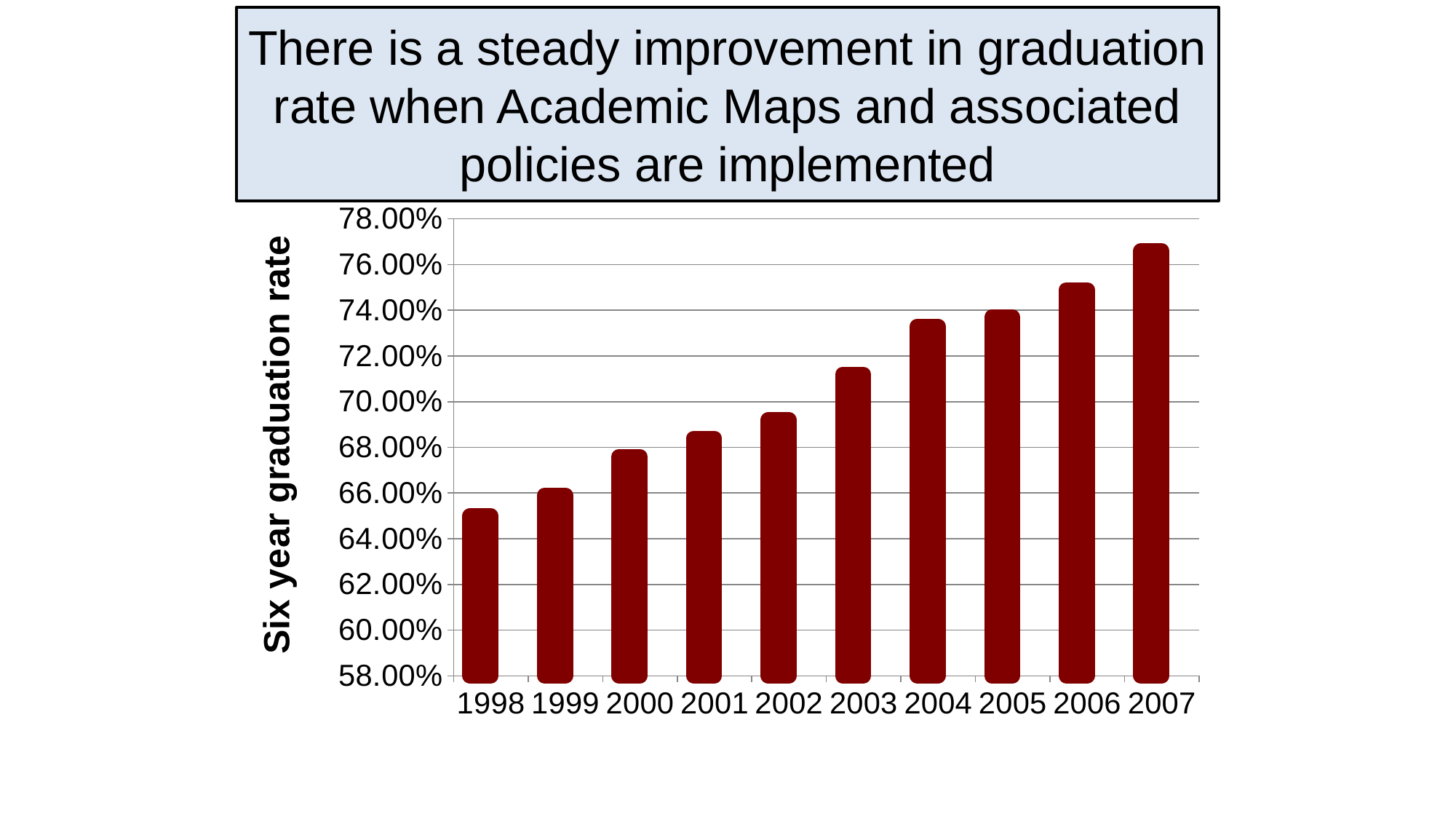
Is the value for 2006 greater or less than 74.00%? greater Is the value for 2007 greater or less than 76.00%? greater Which year has the highest six year graduation rate? 2007 How many years are plotted on the x axis of the chart? 10 What is the label on the vertical axis of the chart? Six year graduation rate Do the graduation rates rise or fall from 1998 to 2007? rise What kind of chart is shown on the slide? bar chart Is the value for 2003 greater or less than 70.00%? greater Which year has the larger graduation rate, 2003 or 2006? 2006 Which year has the lowest six year graduation rate? 1998